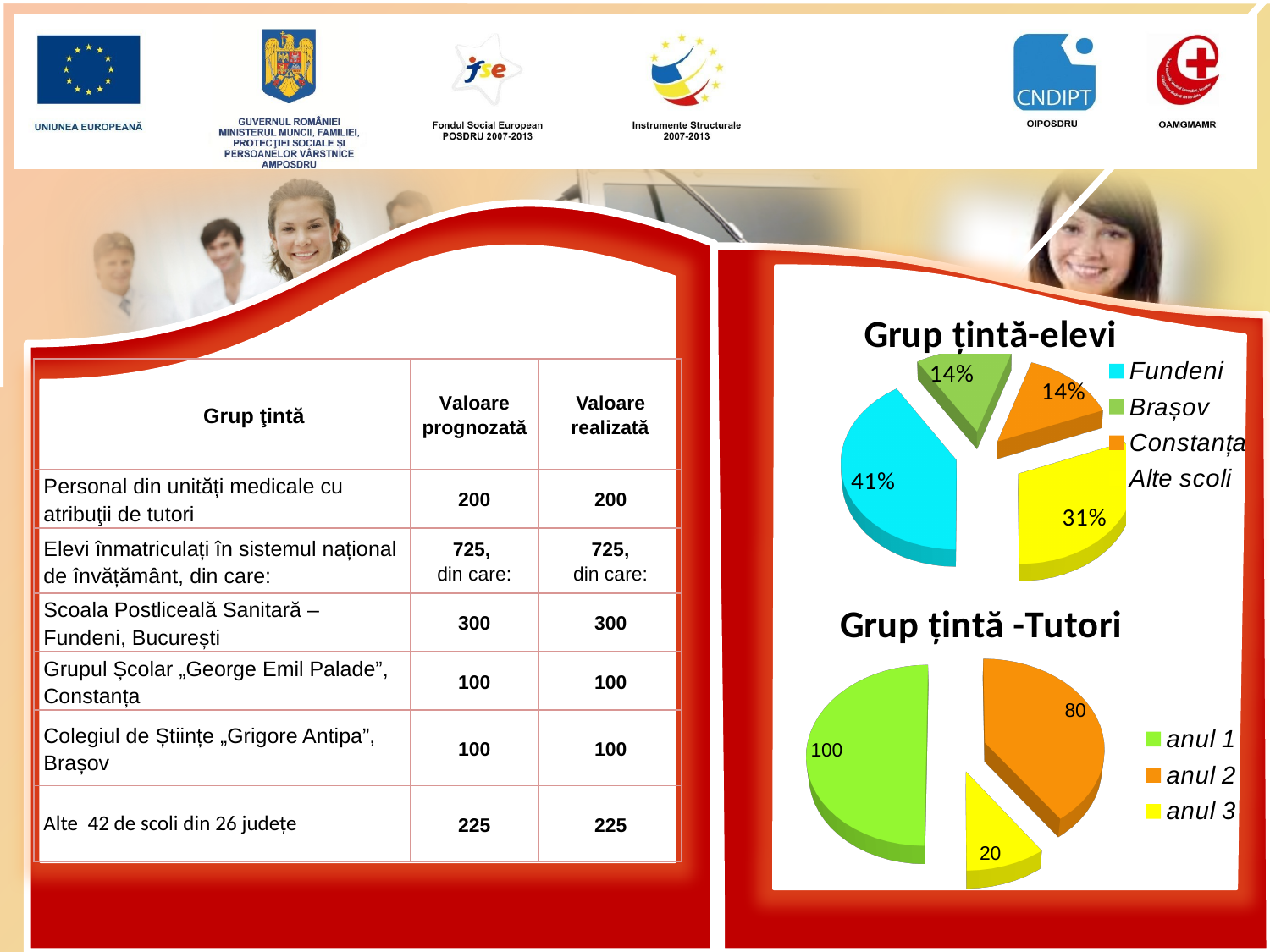
In the 'Grup țintă -Tutori' chart, what is the value for anul 2? 80 In the 'Grup țintă-elevi' chart, what share does Alte scoli have? 31% What type of chart is 'Grup țintă -Tutori'? Pie chart In the 'Grup țintă-elevi' chart, what share does Fundeni have? 41% In the 'Grup țintă-elevi' chart, how many slices does the pie have? 4 In the 'Grup țintă -Tutori' chart, what is the value for anul 3? 20 In the 'Grup țintă -Tutori' chart, which category has the smallest value? anul 3 In the 'Grup țintă-elevi' chart, which category has the largest share? Fundeni In the 'Grup țintă-elevi' chart, what share does Brașov have? 14% In the 'Grup țintă-elevi' chart, what is the difference between the shares of Fundeni and Alte scoli? 10% In the 'Grup țintă -Tutori' chart, which is larger, anul 1 or anul 2? anul 1 In the 'Grup țintă -Tutori' chart, what is the total of all three slices? 200